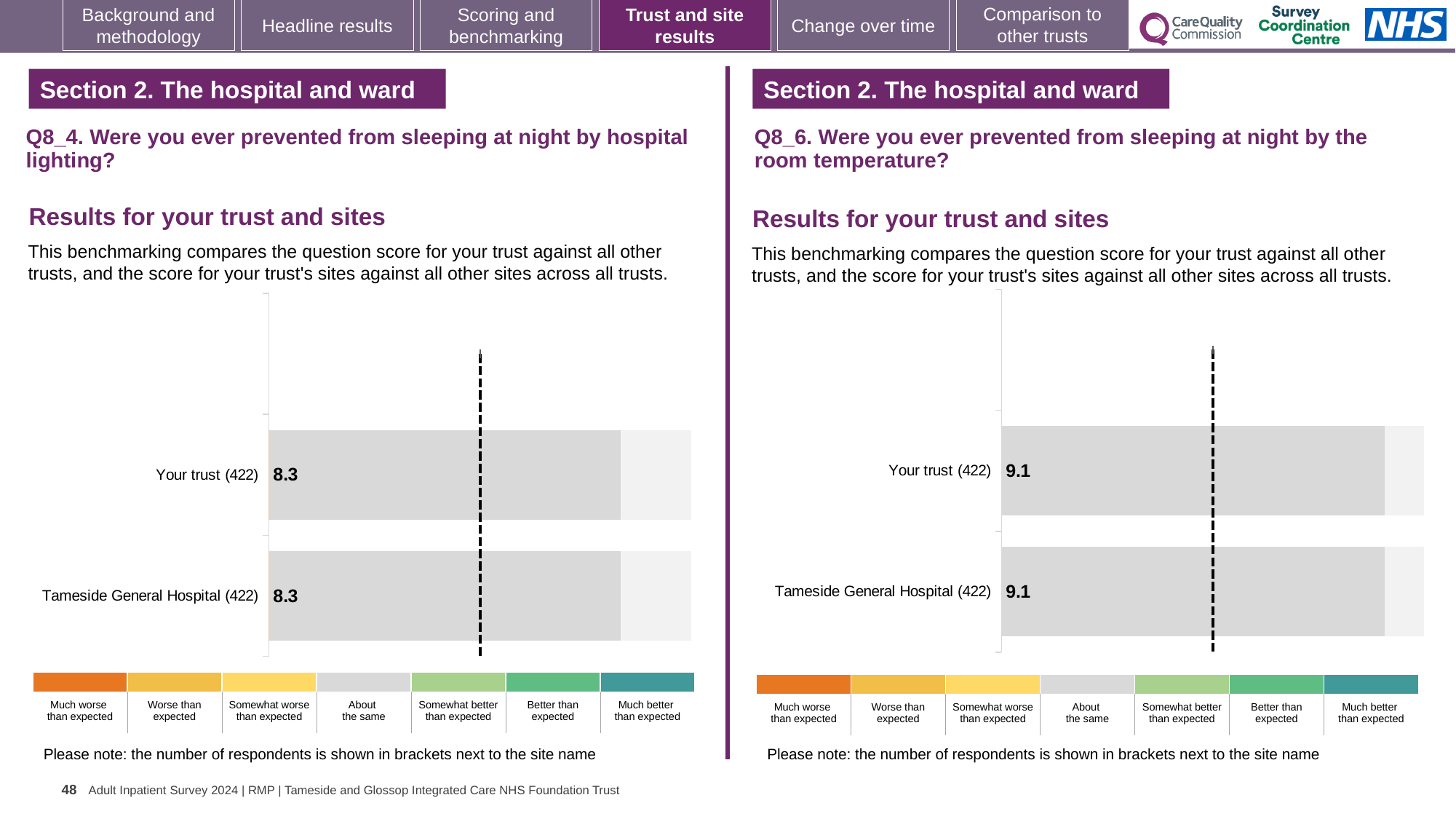
What kind of chart is used for the Q8_6 room temperature results? Bar chart On the Q8_4 hospital lighting chart, what is the difference between the score for Your trust and the score for Tameside General Hospital? 0 On the Q8_4 hospital lighting chart, what is the score for Tameside General Hospital (422)? 8.3 Is the Your trust score on the Q8_6 room temperature chart higher or lower than the Your trust score on the Q8_4 hospital lighting chart? Higher How many bars are plotted on the Q8_6 room temperature chart? 2 On the Q8_6 room temperature chart, which benchmark category does the grey colour of the bars correspond to in the legend? About the same On the Q8_6 room temperature chart, what is the score for Your trust (422)? 9.1 On the Q8_6 room temperature chart, what is the difference between the score for Your trust and the score for Tameside General Hospital? 0 How many bars are plotted on the Q8_4 hospital lighting chart? 2 On the Q8_4 hospital lighting chart, how many respondents are shown in brackets next to Tameside General Hospital? 422 On the Q8_4 hospital lighting chart, what is the score for Your trust (422)? 8.3 On the Q8_6 room temperature chart, what is the score for Tameside General Hospital (422)? 9.1